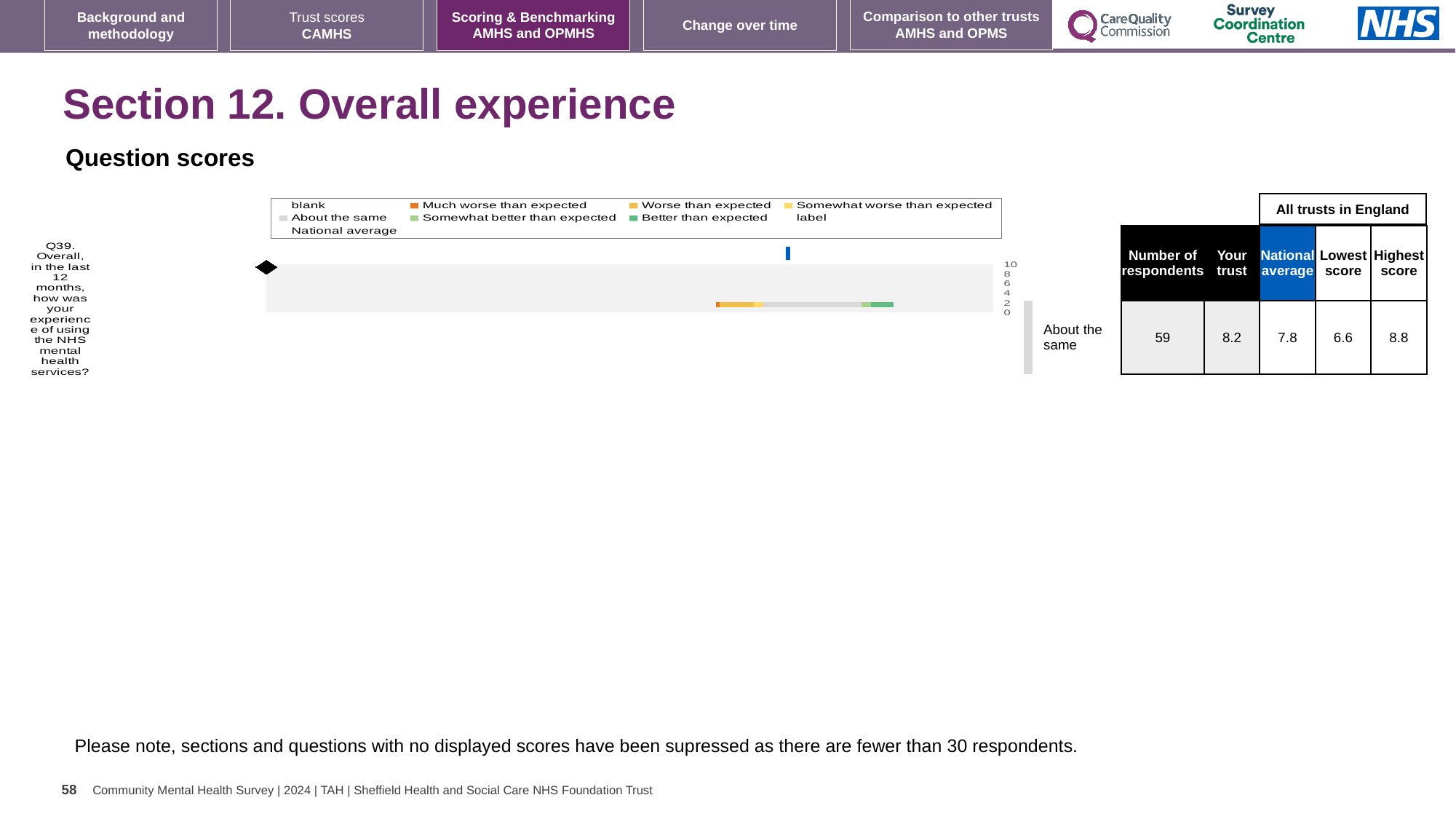
What is the lowest score among all trusts in England for Q39? 6.6 How many respondents answered Q39? 59 How many questions are plotted in the Question scores chart? 1 What is the difference between the highest and lowest trust scores for Q39? 2.2 What is the highest score among all trusts in England for Q39? 8.8 By how much does the trust's Q39 score exceed the national average? 0.4 What kind of chart is used to show the Q39 question score? bar chart What is the 'Your trust' score for Q39 (overall experience of using NHS mental health services)? 8.2 Is the trust's score for Q39 higher or lower than the national average? higher Which benchmark category is the trust's Q39 score placed in? About the same What does the blue marker in the chart legend represent? National average What is the national average score for Q39? 7.8